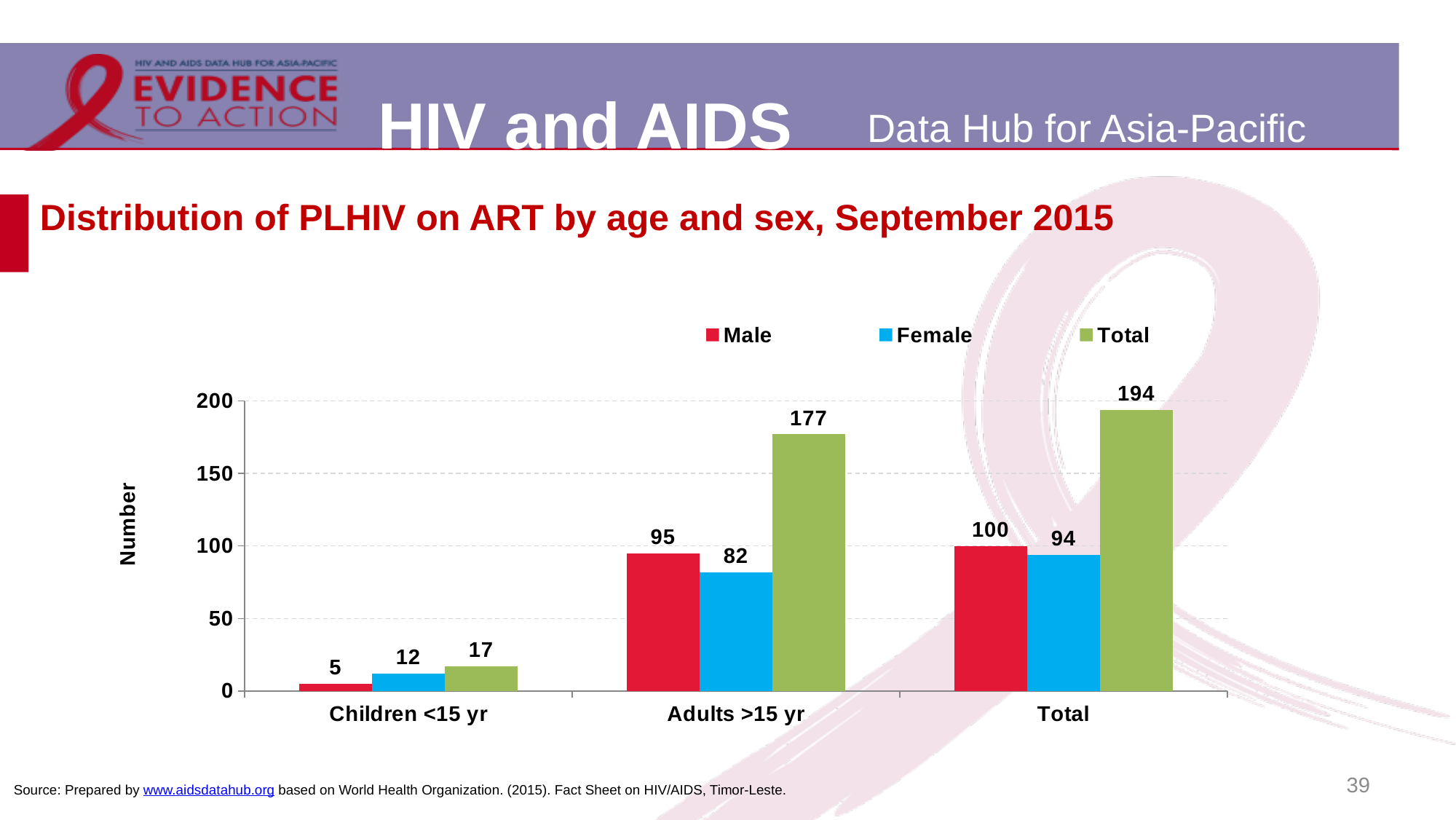
How many categories are shown on the x axis? 3 What is the Female value for Children <15 yr? 12 Which category has the highest Total value? Total What is the Total value for the Total category? 194 How many series does the legend list? 3 Which is larger for Children <15 yr, the Male value or the Female value? Female What kind of chart is shown on the slide? bar chart What is the difference between the Male and Female values for Adults >15 yr? 13 What is the Male value for Adults >15 yr? 95 Which category has the lowest Male value? Children <15 yr What is the label of the y axis? Number Is the Total value for Adults >15 yr greater or less than 150? greater